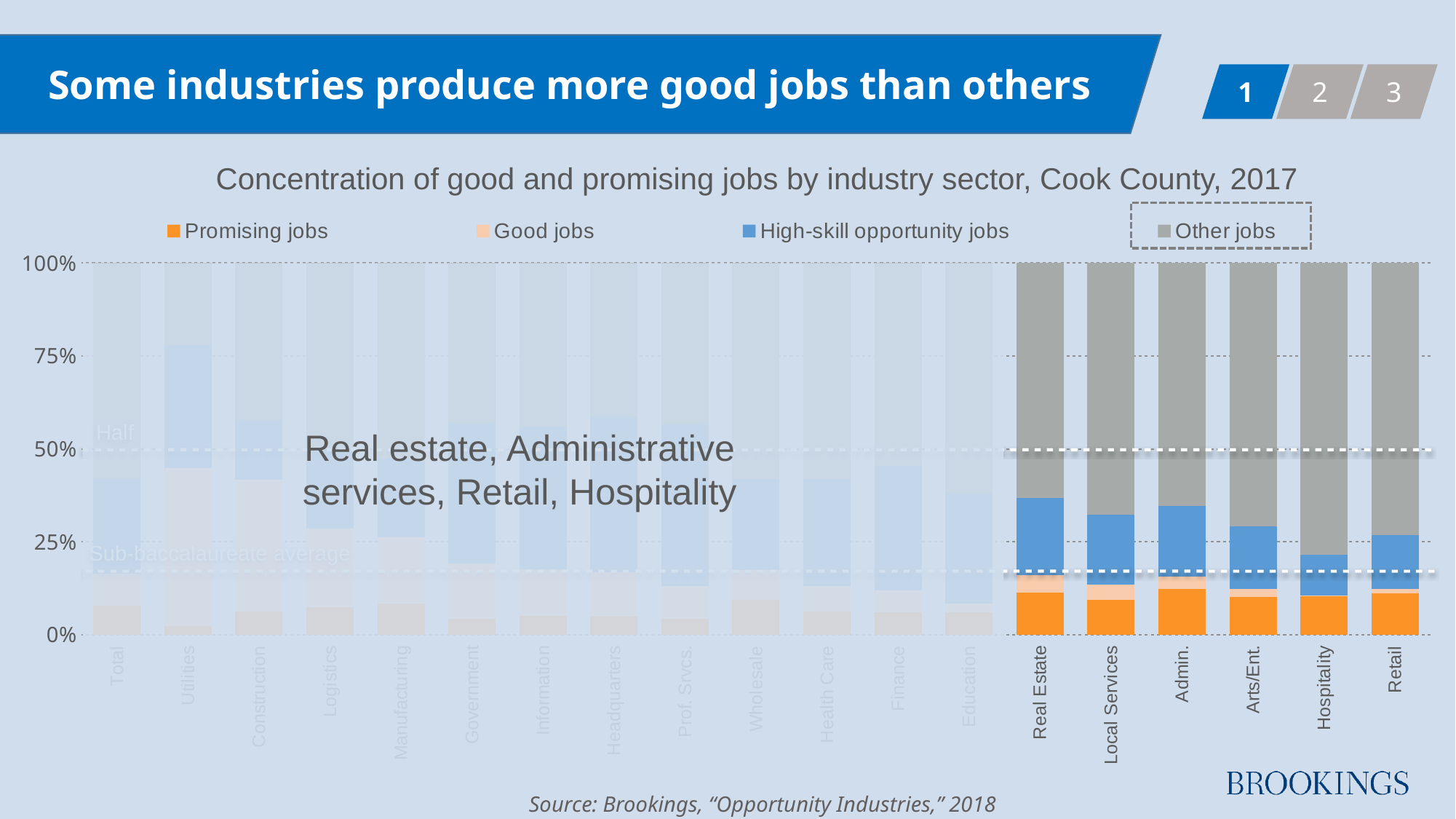
How many industry categories are shown along the x axis of the chart? 19 How many series does the chart legend list? 4 Is the share of Promising jobs for Real Estate greater or less than 25%? less Among the highlighted industries (Real Estate, Local Services, Admin., Arts/Ent., Hospitality, Retail), which has the largest share of Other jobs? Hospitality Which legend entry is outlined with a dashed box? Other jobs Is the combined share of promising, good and high-skill opportunity jobs for Hospitality greater or less than 25%? less What kind of chart is shown on the slide? Stacked bar chart Is the share of Other jobs for Real Estate greater or less than 50%? greater What is the title of the chart? Concentration of good and promising jobs by industry sector, Cook County, 2017 What does each stacked bar in the chart total? 100% Which has a larger combined share of promising, good and high-skill opportunity jobs: Real Estate or Hospitality? Real Estate